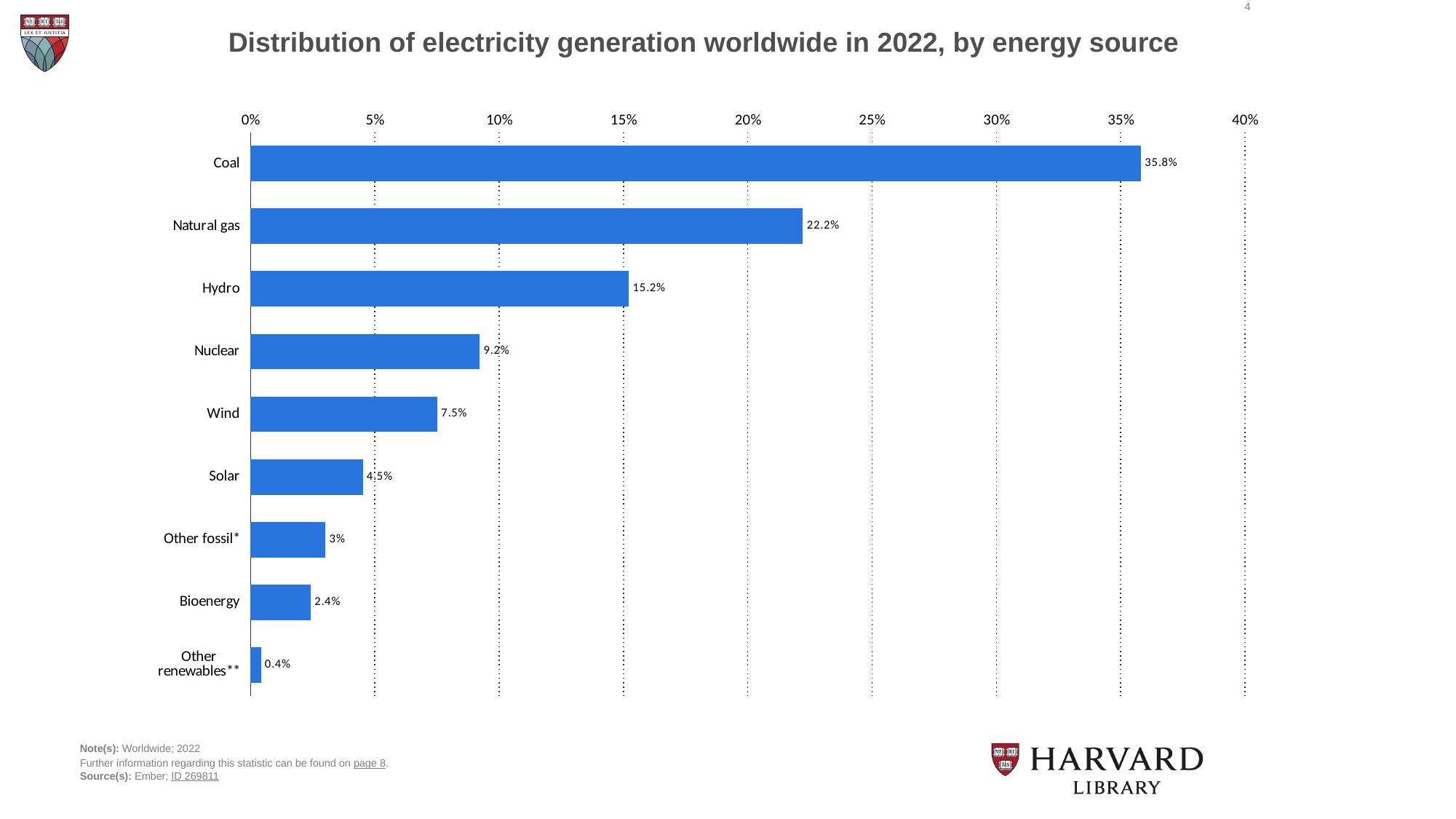
What is the difference between the shares for Hydro and Nuclear? 6% Which has a larger share, Solar or Other fossil*? Solar Which energy source has the lowest share of electricity generation? Other renewables** What is the value shown for Other renewables**? 0.4% What is the value shown for Natural gas? 22.2% What share of electricity generation does Coal account for? 35.8% Which energy source has the highest share of electricity generation? Coal What kind of chart is shown on the slide? Bar chart How many energy sources are shown in the chart? 9 What is the value shown for Wind? 7.5% What is the difference between the shares for Coal and Natural gas? 13.6% Is the value for Hydro greater or less than 15%? greater